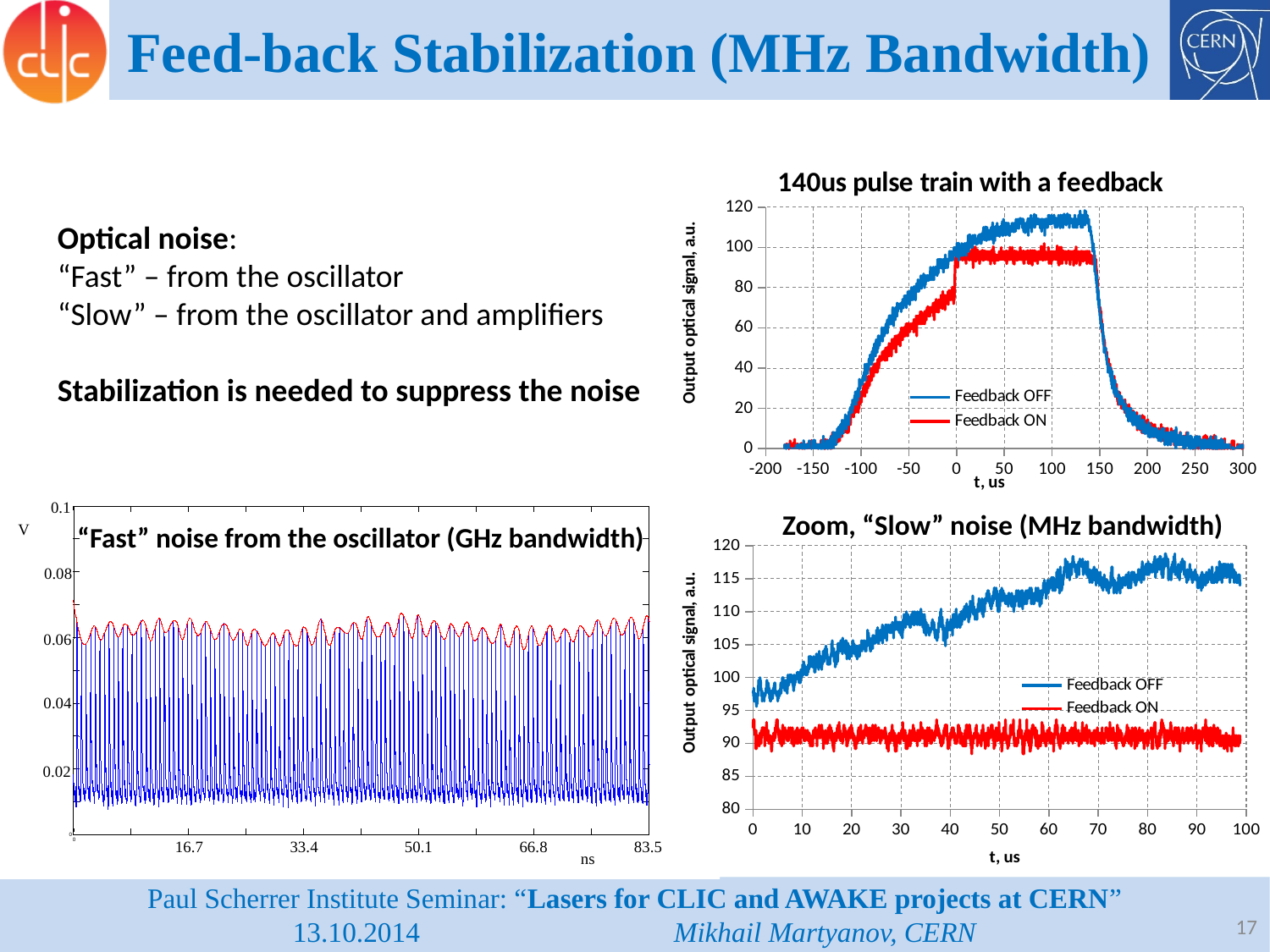
In the chart titled "140us pulse train with a feedback", is the Feedback OFF value at t = 100 us greater or less than 100? greater In the chart titled "Zoom, “Slow” noise (MHz bandwidth)", how many series does the legend list? 2 In the chart titled "140us pulse train with a feedback", is the Feedback ON value at t = -50 us greater or less than 40? greater In the chart titled "Zoom, “Slow” noise (MHz bandwidth)", which series has the higher value at t = 20 us, Feedback OFF or Feedback ON? Feedback OFF What kind of chart is the "140us pulse train with a feedback" chart? line chart In the chart titled "140us pulse train with a feedback", which series has the higher value at t = 100 us, Feedback OFF or Feedback ON? Feedback OFF In the bottom-left chart titled "“Fast” noise from the oscillator (GHz bandwidth)", what unit is shown on the x axis? ns In the chart titled "Zoom, “Slow” noise (MHz bandwidth)", is the Feedback ON value at t = 50 us greater or less than 95? less In the chart titled "140us pulse train with a feedback", how many series does the legend list? 2 In the chart titled "Zoom, “Slow” noise (MHz bandwidth)", does the Feedback OFF series generally rise or fall from t = 0 to t = 100 us? rise In the chart titled "140us pulse train with a feedback", what are the two legend entries? Feedback OFF and Feedback ON